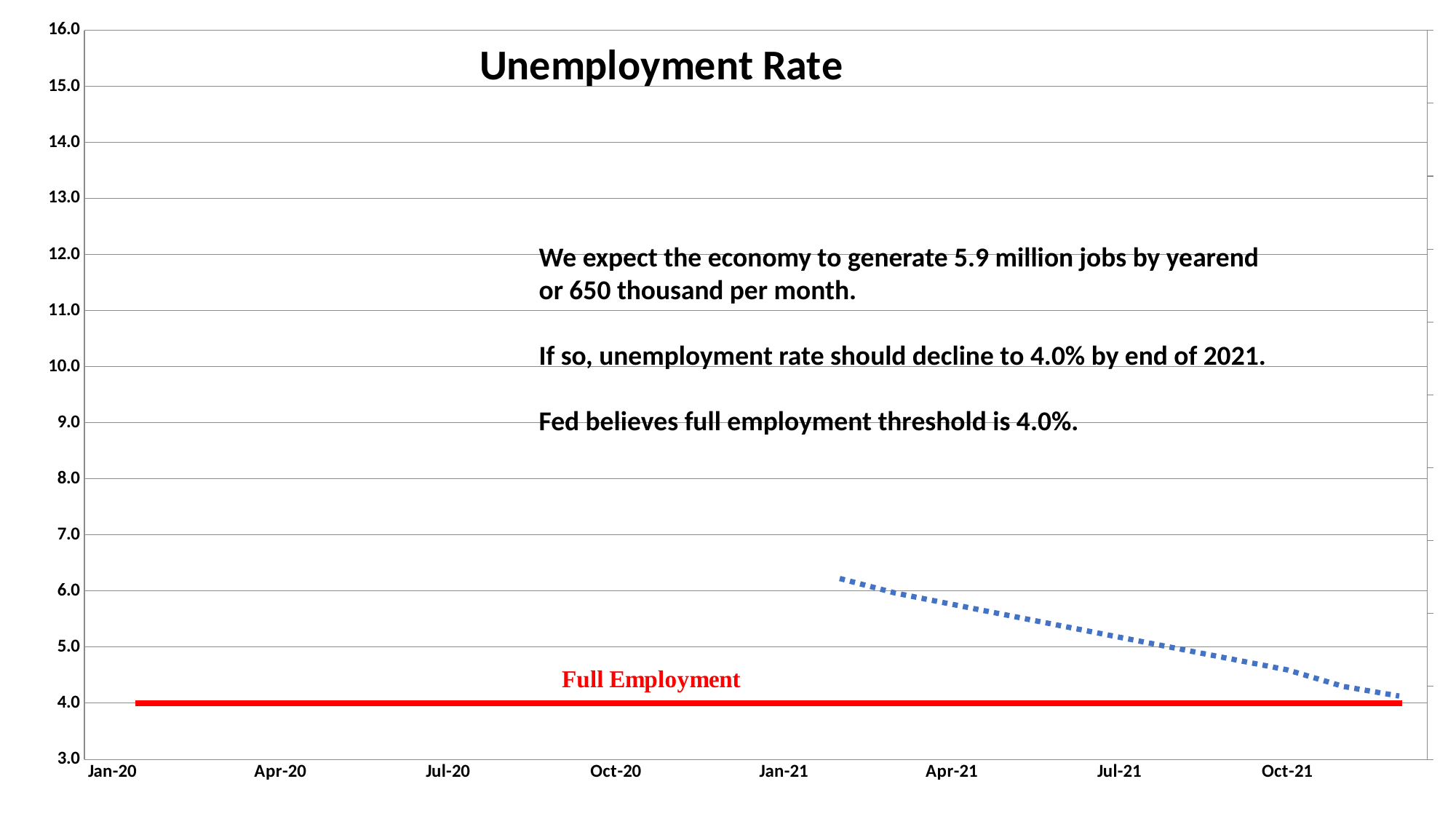
Is the value of the blue dotted line at Oct-21 greater or less than 5.0? less What label is printed on the solid red horizontal line? Full Employment At Apr-21, which is higher: the blue dotted line or the red Full Employment line? the blue dotted line How many date labels are shown on the x axis? 8 What is the highest value shown on the y axis? 16.0 Does the blue dotted line rise or fall from Jan-21 toward the end of 2021? fall At what value on the y axis does the solid red Full Employment line sit? 4.0 What is the title of the chart? Unemployment Rate Is the value of the blue dotted line at Apr-21 greater or less than 5.0? greater Is the starting value of the blue dotted line greater or less than 7.0? less What type of chart is shown on the slide? line chart Which date label appears first on the x axis? Jan-20